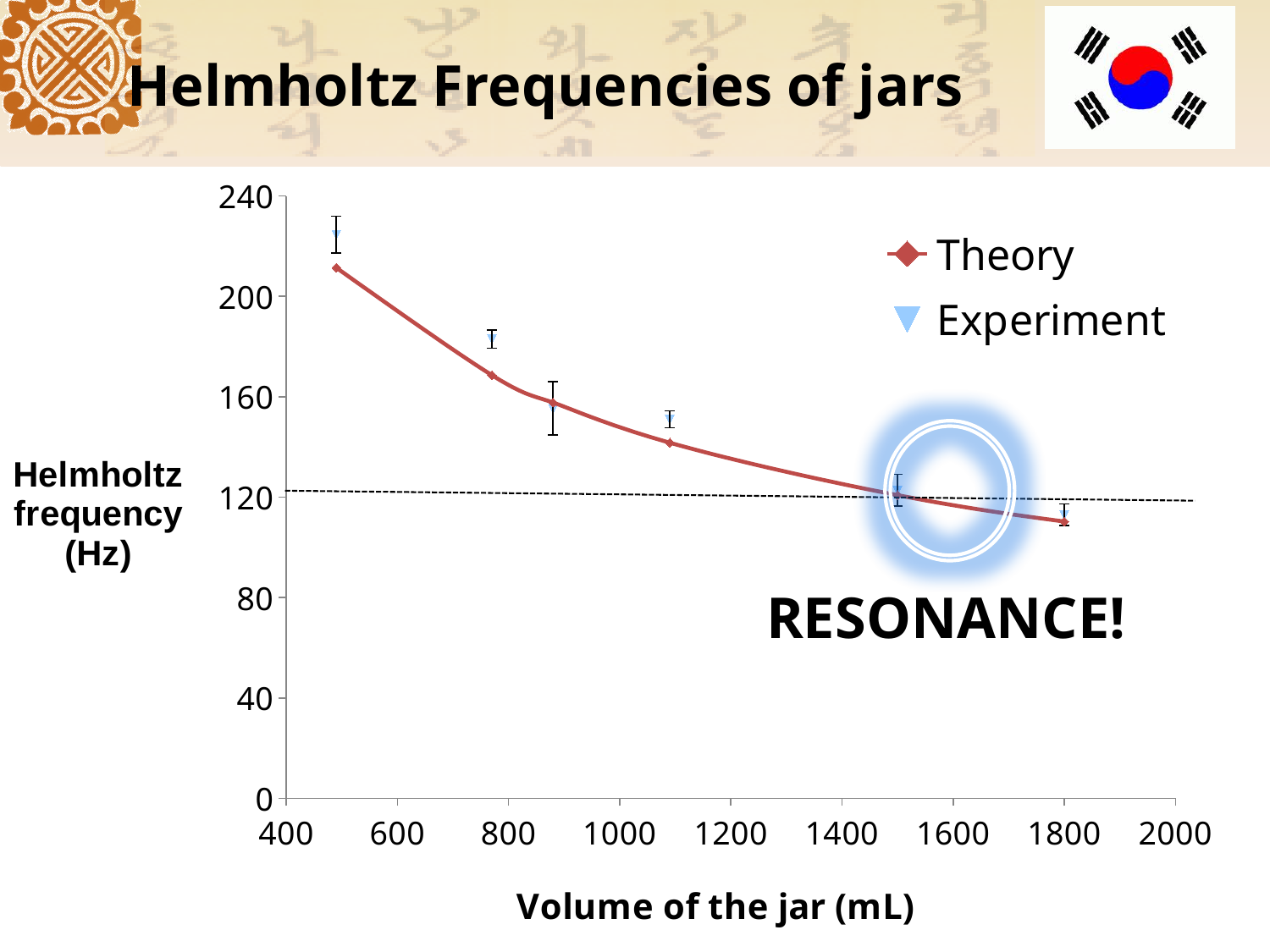
Is the Experiment value at about 800 mL greater or less than 160 Hz? greater Do the Theory values rise or fall as the volume of the jar increases? fall What are the two series named in the legend? Theory and Experiment Is the Experiment value at the smallest jar volume (about 500 mL) greater or less than 200 Hz? greater Is the Theory value at the largest jar volume (about 1800 mL) greater or less than 120 Hz? less How many Theory data points are plotted? 6 How many series does the legend list? 2 Which series has the higher value at the smallest jar volume (about 500 mL), Theory or Experiment? Experiment What kind of chart is shown on the slide? line chart What is the label of the x axis? Volume of the jar (mL)